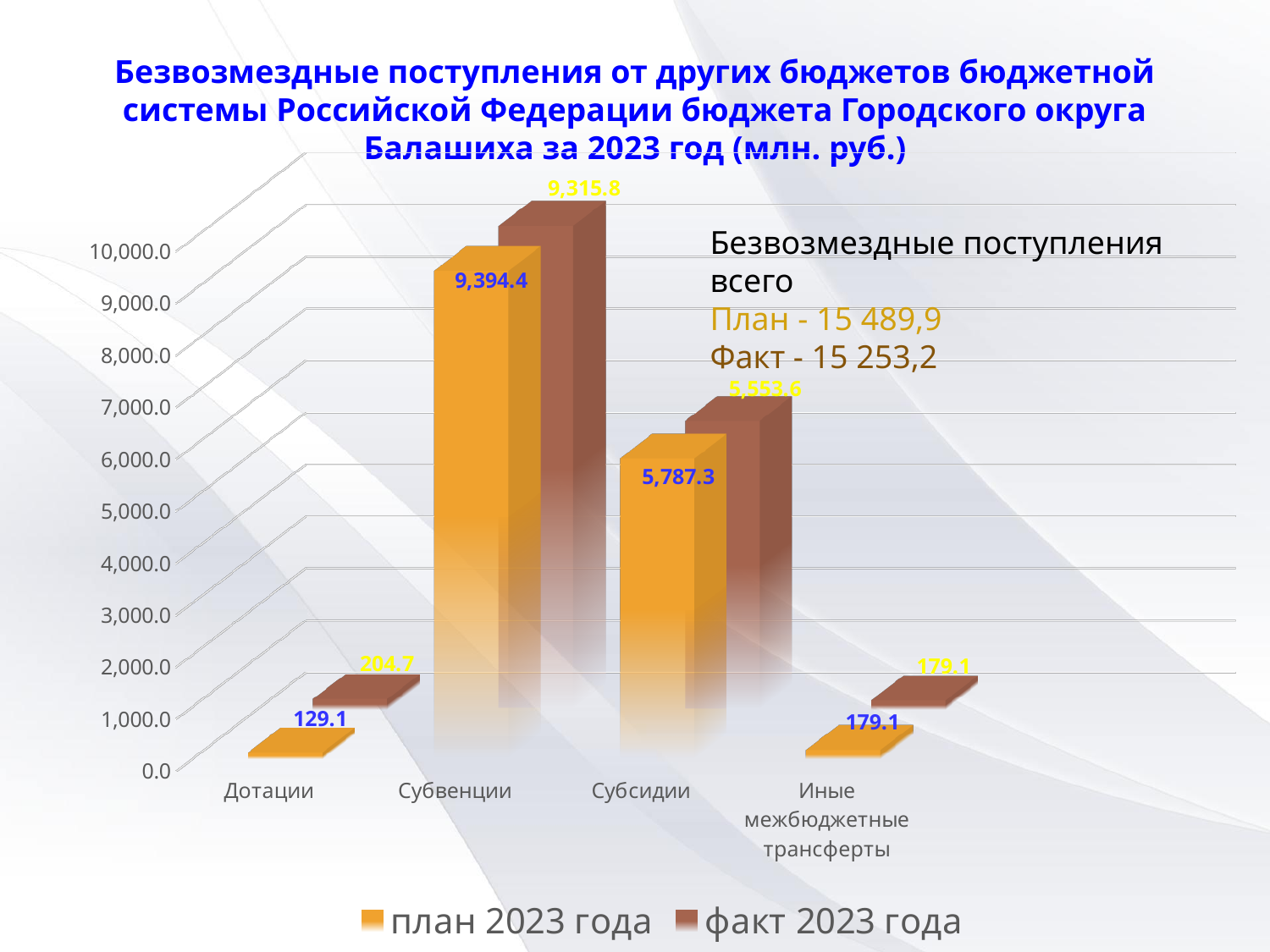
What is the факт 2023 года value for Субсидии? 5,553.6 What kind of chart is shown on the slide? bar chart Which category has the lowest план 2023 года value? Дотации How many categories are shown on the x axis? 4 What is the факт 2023 года value for Дотации? 204.7 What is the план 2023 года value for Субвенции? 9,394.4 What is the план 2023 года value for Иные межбюджетные трансферты? 179.1 Which is larger for Субвенции: план 2023 года or факт 2023 года? план 2023 года According to the text on the slide, what is the total факт value of Безвозмездные поступления всего? 15 253,2 What is the difference between the план 2023 года and факт 2023 года values for Субсидии? 233.7 How many series does the legend list? 2 Which category has the highest факт 2023 года value? Субвенции